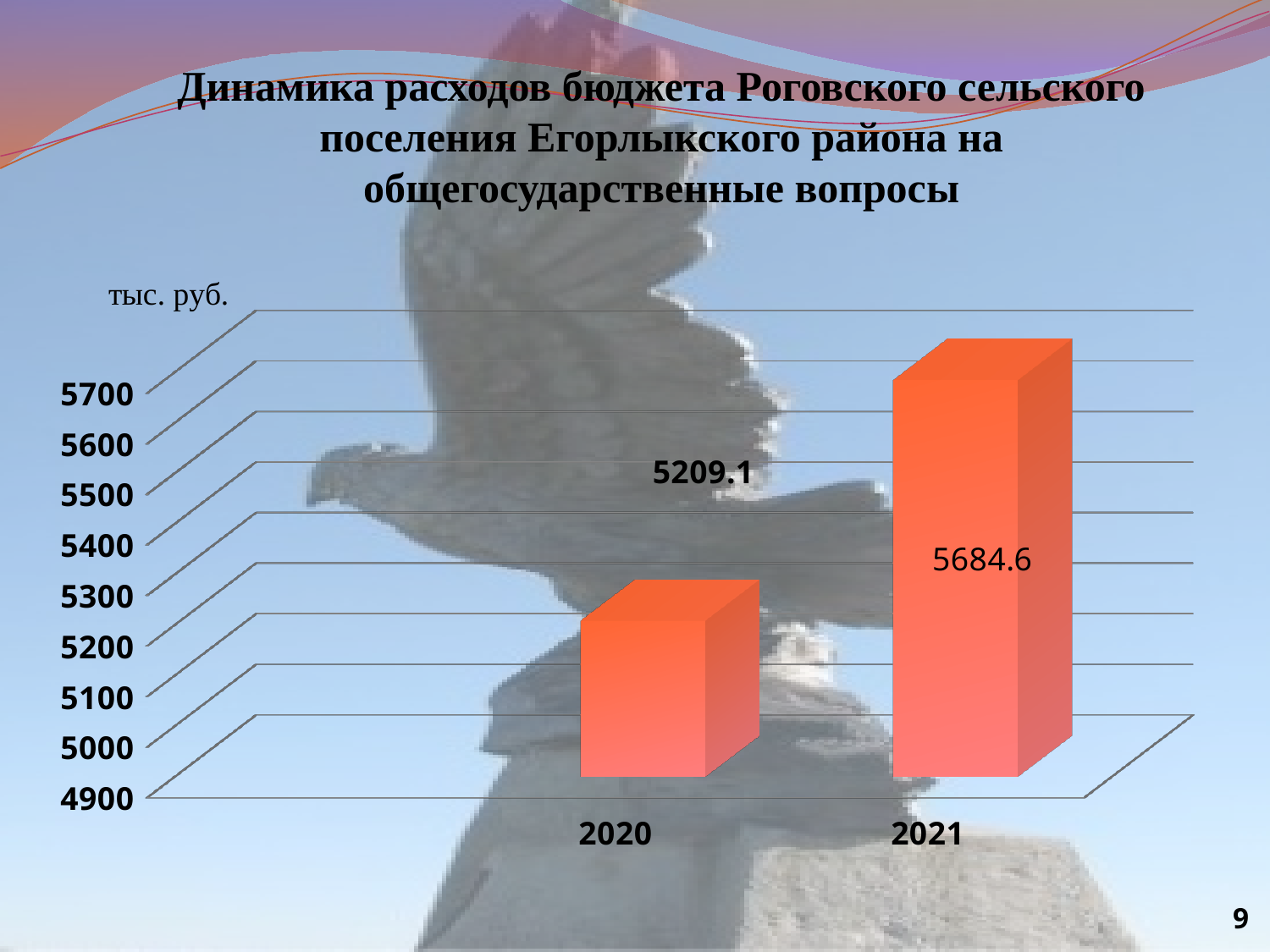
Is the value for 2020 greater or less than 5300? less Is the value for 2021 greater or less than 5600? greater How many years are shown on the x axis? 2 What is the difference between the values for 2021 and 2020? 475.5 Which year has the highest value? 2021 What is the value for 2020? 5209.1 What kind of chart is shown on the slide? bar chart Which year has the lowest value? 2020 What unit of measurement is indicated above the chart? тыс. руб. Which is larger, the value for 2020 or the value for 2021? 2021 Do the values rise or fall from 2020 to 2021? rise What is the value for 2021? 5684.6